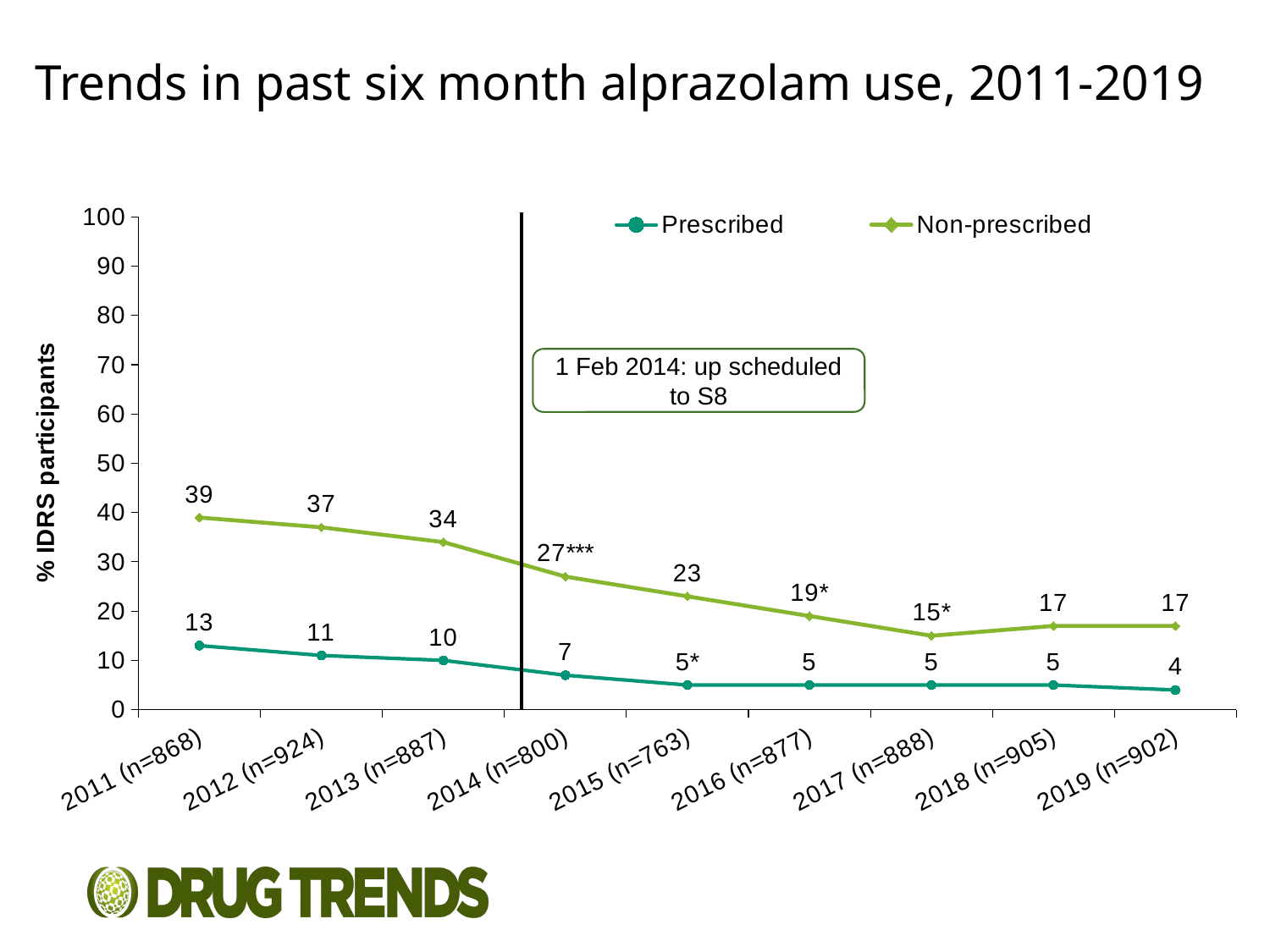
Which series has the larger value in 2014 (n=800), Prescribed or Non-prescribed? Non-prescribed What is the Non-prescribed value for 2011 (n=868)? 39 What is the difference between the Non-prescribed and Prescribed values in 2011 (n=868)? 26 What is the Non-prescribed value for 2015 (n=763)? 23 In which year is the Non-prescribed series highest? 2011 (n=868) What is the Prescribed value for 2019 (n=902)? 4 How many years are shown on the x axis? 9 How many series does the legend list? 2 What event does the annotation box on the chart describe? 1 Feb 2014: up scheduled to S8 What kind of chart is shown on the slide? Line chart In which year is the Prescribed series lowest? 2019 (n=902) Does the Non-prescribed series generally rise or fall from 2011 to 2017? Fall